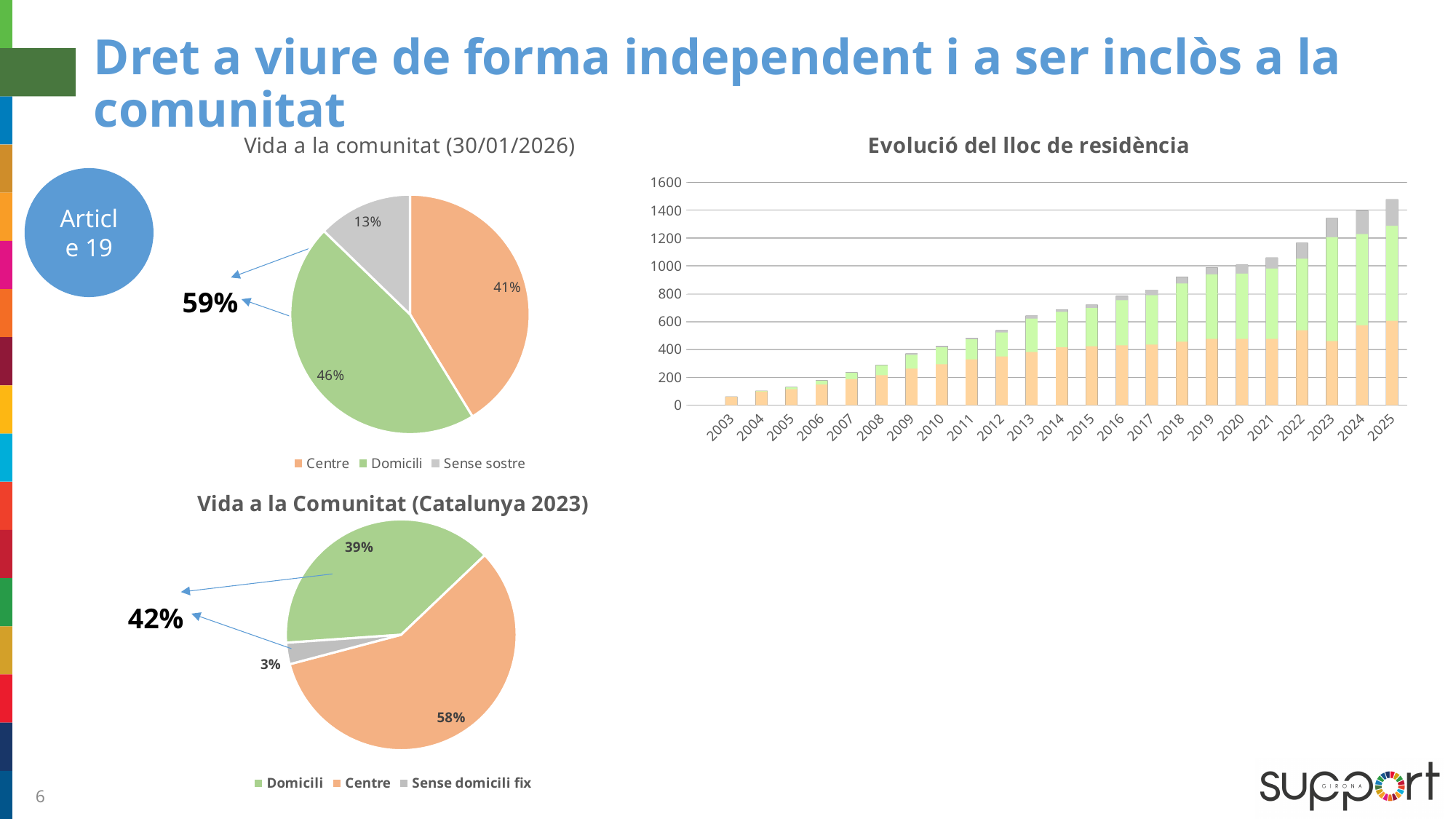
In the 'Vida a la Comunitat (Catalunya 2023)' pie chart, what percentage is shown for Centre? 58% In the 'Vida a la comunitat (30/01/2026)' pie chart, what percentage is shown for Domicili? 46% What kind of chart is 'Evolució del lloc de residència'? Stacked bar chart In the 'Vida a la comunitat (30/01/2026)' pie chart, which category has the largest share? Domicili In the 'Vida a la comunitat (30/01/2026)' pie chart, what percentage is shown for Sense sostre? 13% How many years are shown on the x axis of the 'Evolució del lloc de residència' chart? 23 In the 'Vida a la Comunitat (Catalunya 2023)' pie chart, which category has the smallest share? Sense domicili fix In the 'Vida a la comunitat (30/01/2026)' pie chart, what is the difference in percentage points between Domicili and Centre? 5 In the 'Evolució del lloc de residència' chart, is the total for 2025 greater or less than 1400? greater In the 'Evolució del lloc de residència' chart, do the total bar heights rise or fall from 2003 to 2025? Rise In the 'Vida a la Comunitat (Catalunya 2023)' pie chart, which is larger, Domicili or Centre? Centre How many categories does the legend of the 'Vida a la Comunitat (Catalunya 2023)' pie chart list? 3